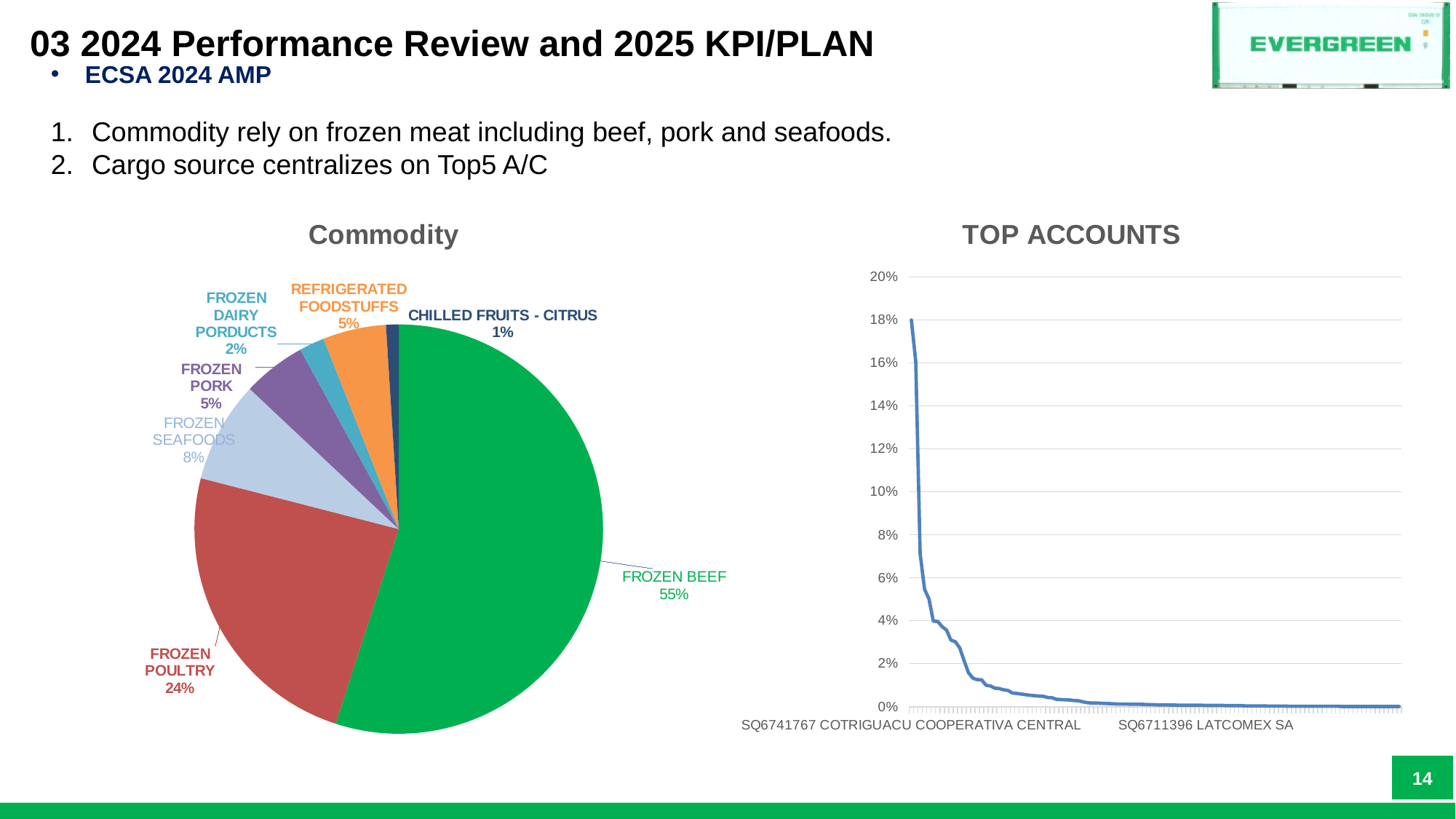
In the TOP ACCOUNTS chart, do the values rise or fall from left to right? Fall In the Commodity chart, what share does FROZEN BEEF have? 55% In the Commodity chart, which commodity has the largest share? FROZEN BEEF In the Commodity chart, what share does FROZEN SEAFOODS have? 8% In the Commodity chart, which commodity has the smallest share? CHILLED FRUITS - CITRUS How many slices does the Commodity pie chart have? 7 What kind of chart is the TOP ACCOUNTS chart? Line chart What kind of chart is the Commodity chart? Pie chart In the Commodity chart, what share does FROZEN POULTRY have? 24% In the TOP ACCOUNTS chart, is the value for the first account on the left greater or less than 16%? greater In the Commodity chart, what is the difference in share between FROZEN BEEF and FROZEN POULTRY? 31% In the Commodity chart, which is larger, FROZEN SEAFOODS or FROZEN PORK? FROZEN SEAFOODS